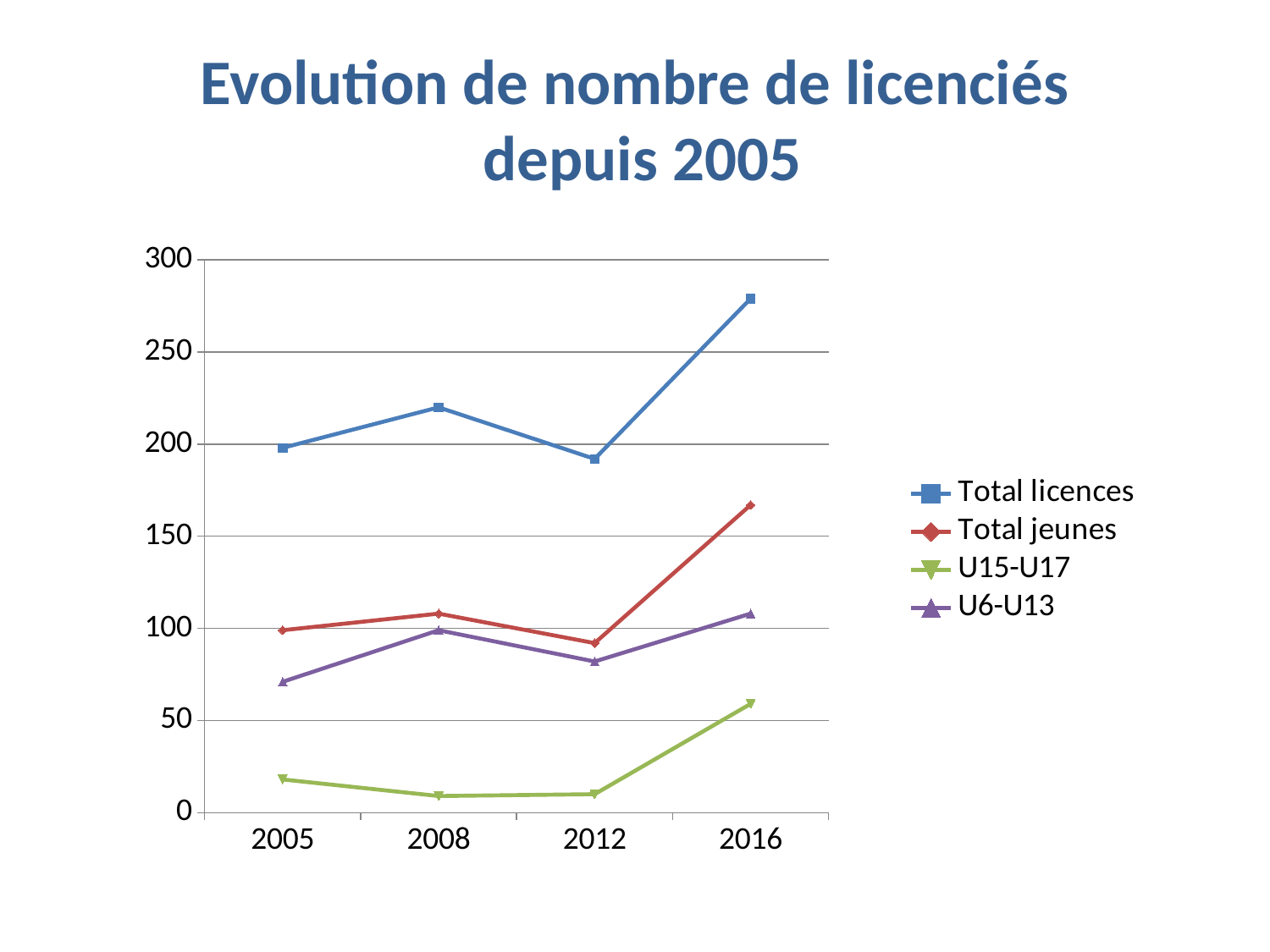
What is the title of the chart? Evolution de nombre de licenciés depuis 2005 What kind of chart is shown on the slide? line chart Which is larger in 2016: Total jeunes or U6-U13? Total jeunes Is the value for U15-U17 in 2008 greater or less than 50? less Is the value for U6-U13 in 2005 greater or less than 100? less How many series does the legend list? 4 In which year is the Total licences series at its highest? 2016 Is the value for Total jeunes in 2016 greater or less than 150? greater Does the Total licences series rise or fall from 2012 to 2016? rise In which year is the U6-U13 series at its lowest? 2005 How many years are plotted along the x axis? 4